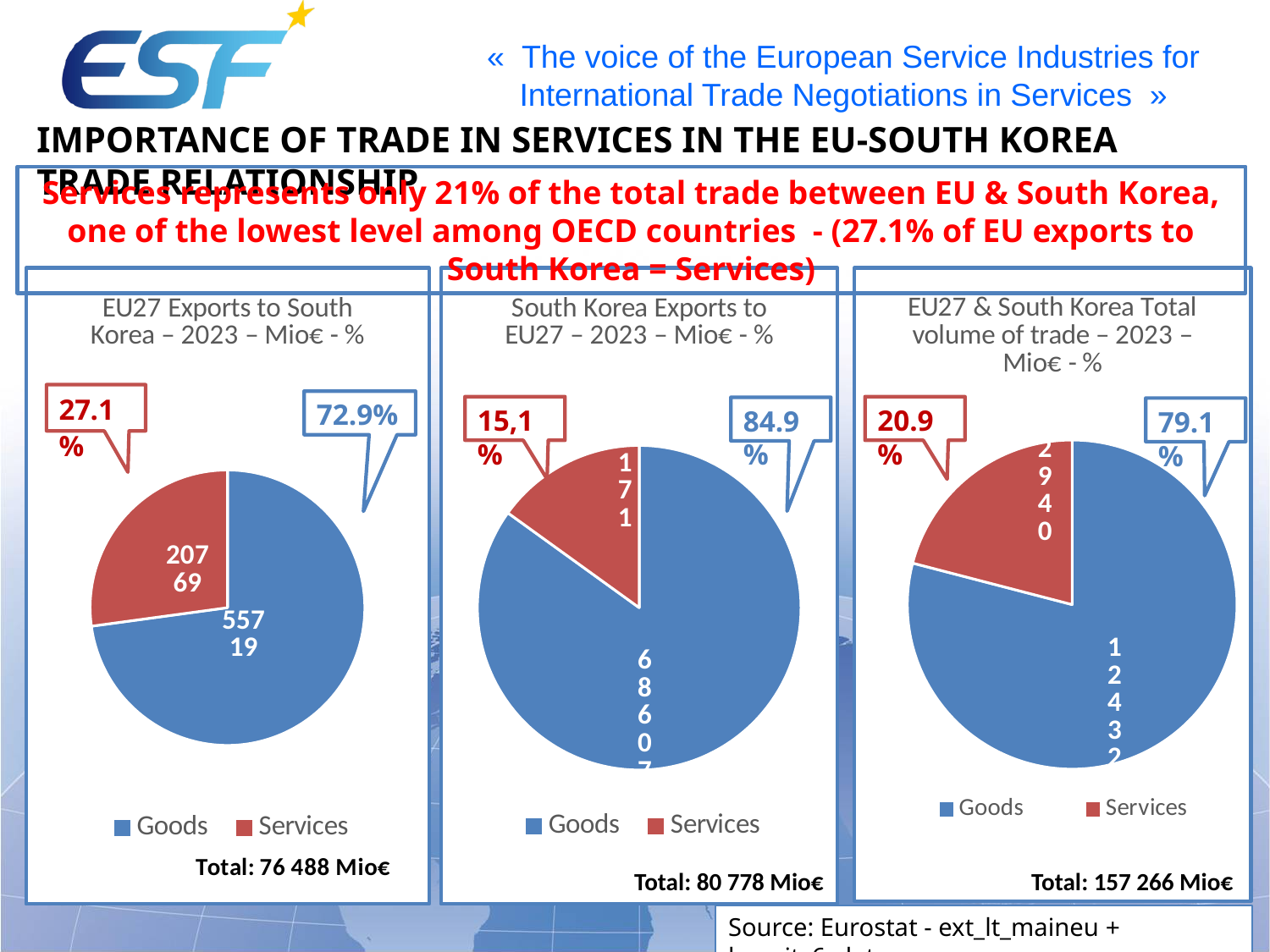
In the 'EU27 & South Korea Total volume of trade' chart, what share of the pie is Services? 20.9% What is the total shown under the 'South Korea Exports to EU27' chart? 80 778 Mio€ In the 'South Korea Exports to EU27' chart, what share of the pie is Services? 15,1% In the 'South Korea Exports to EU27' chart, what share of the pie is Goods? 84.9% What is the total shown under the 'EU27 & South Korea Total volume of trade' chart? 157 266 Mio€ How many categories does the legend of the 'EU27 & South Korea Total volume of trade' chart list? 2 What is the total shown under the 'EU27 Exports to South Korea' chart? 76 488 Mio€ What kind of chart is the 'South Korea Exports to EU27' chart? Pie chart In the 'EU27 Exports to South Korea' chart, which category is larger, Goods or Services? Goods